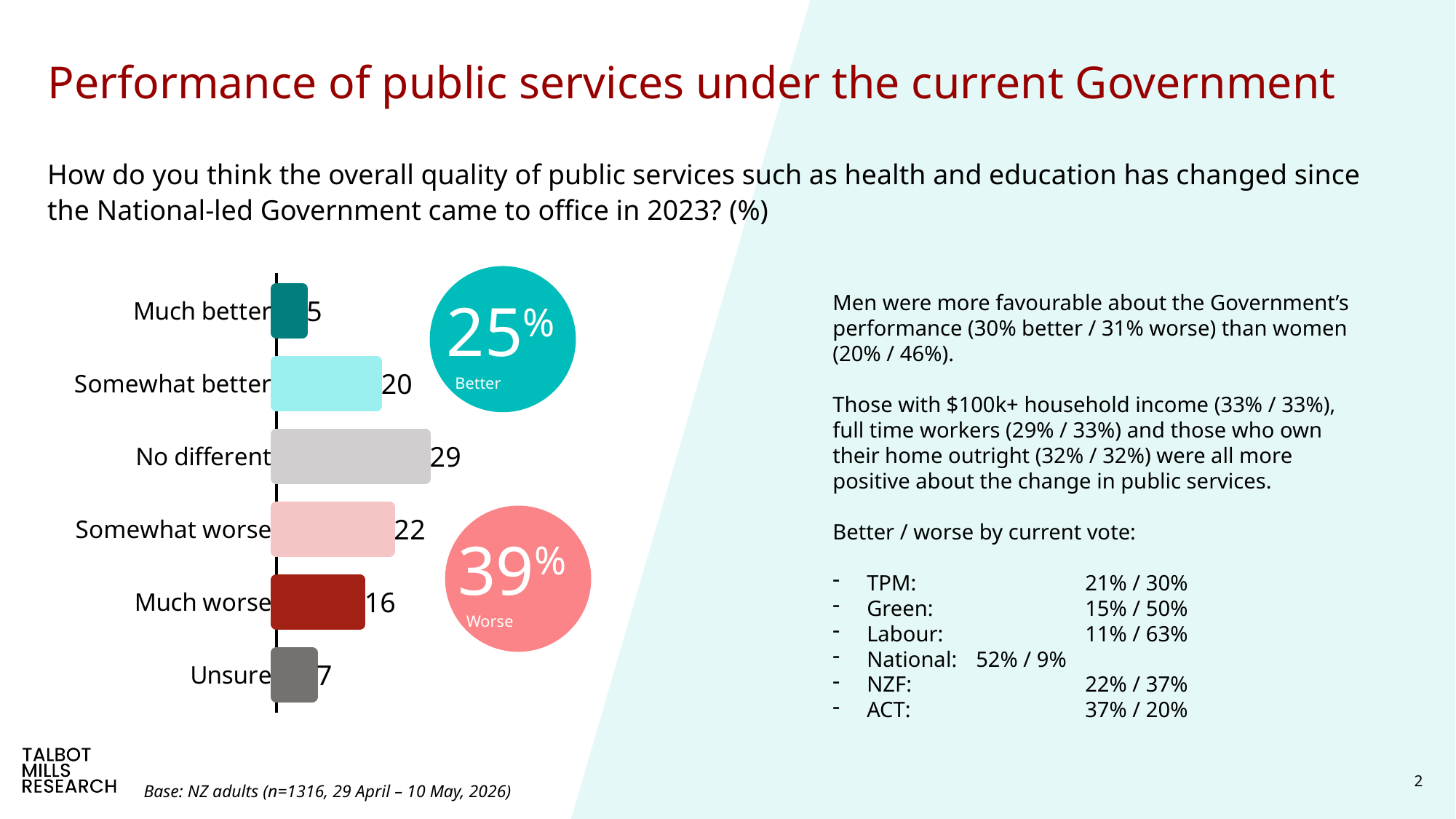
Which is larger, "Much worse" or "Much better"? Much worse Which category has the highest value? No different What is the difference between "Somewhat worse" and "Somewhat better"? 2 What is the value for "No different"? 29 What kind of chart is shown on the slide? Bar chart What is the value for "Unsure"? 7 What percentage is shown in the "Worse" circle? 39% Which category has the lowest value? Much better What is the value for "Somewhat better"? 20 How many categories are shown in the bar chart? 6 What is the value for "Much worse"? 16 What is the combined total of "Much better" and "Somewhat better" as shown in the circle? 25%